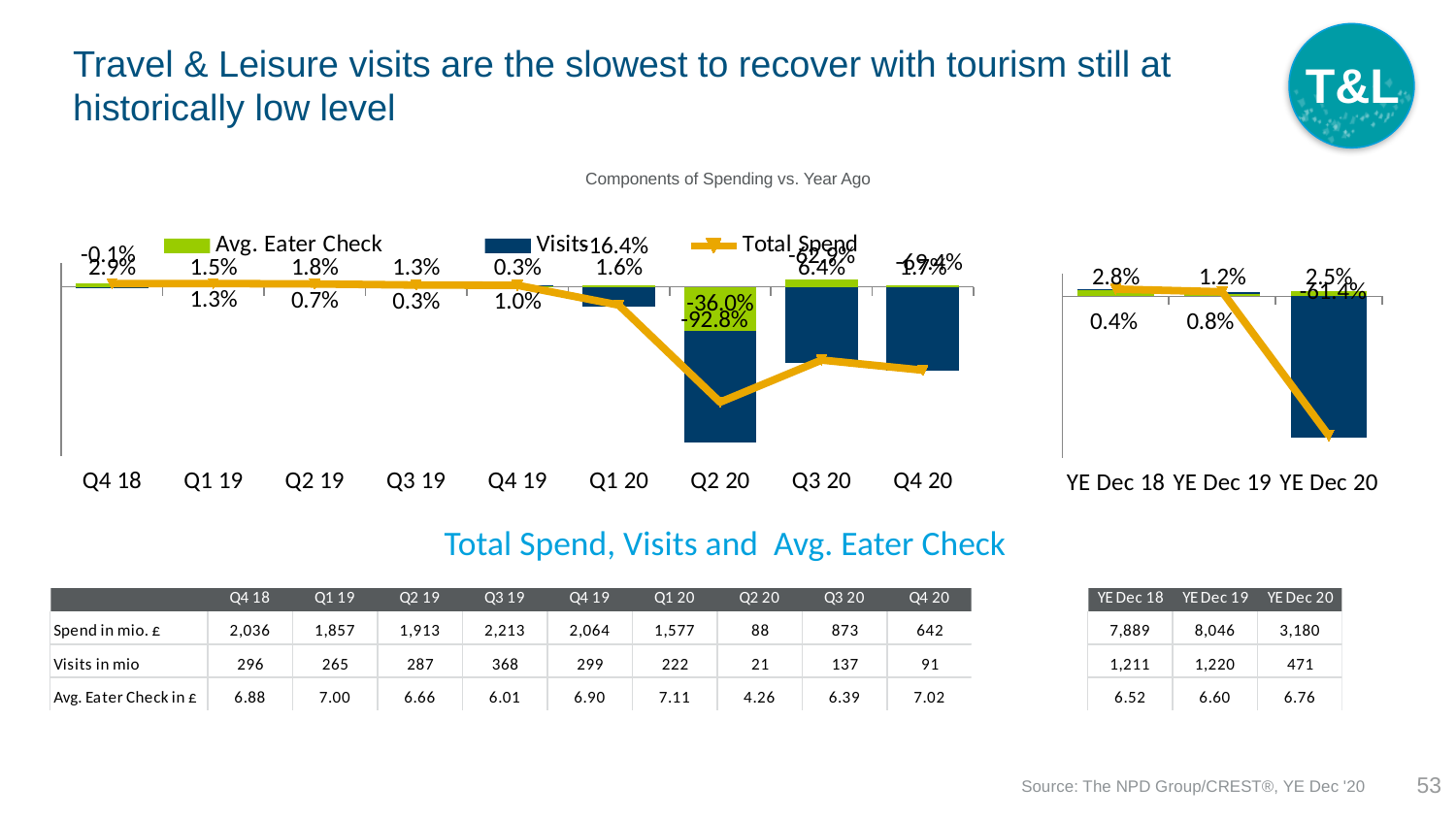
How many series does the legend of the left chart list? 3 In the left chart, what is the Visits value labelled for Q2 20? -92.8% In the yearly table below the right chart, what is the difference in Spend in mio. £ between YE Dec 19 and YE Dec 20? 4,866 In the quarterly table below the left chart, which quarter has the highest Spend in mio. £? Q3 19 In the right chart, does the Total Spend line rise or fall from YE Dec 19 to YE Dec 20? fall In the right chart, what is the Visits value labelled for YE Dec 20? -61.4% What kind of chart is the left chart titled 'Components of Spending vs. Year Ago'? bar and line chart In the quarterly table below the left chart, what is Visits in mio for Q3 19? 368 In the quarterly table below the left chart, what is Spend in mio. £ for Q2 20? 88 How many periods are shown on the x axis of the right chart? 3 In the left chart, which quarter has the lowest Visits bar? Q2 20 How many quarters are shown on the x axis of the left chart? 9